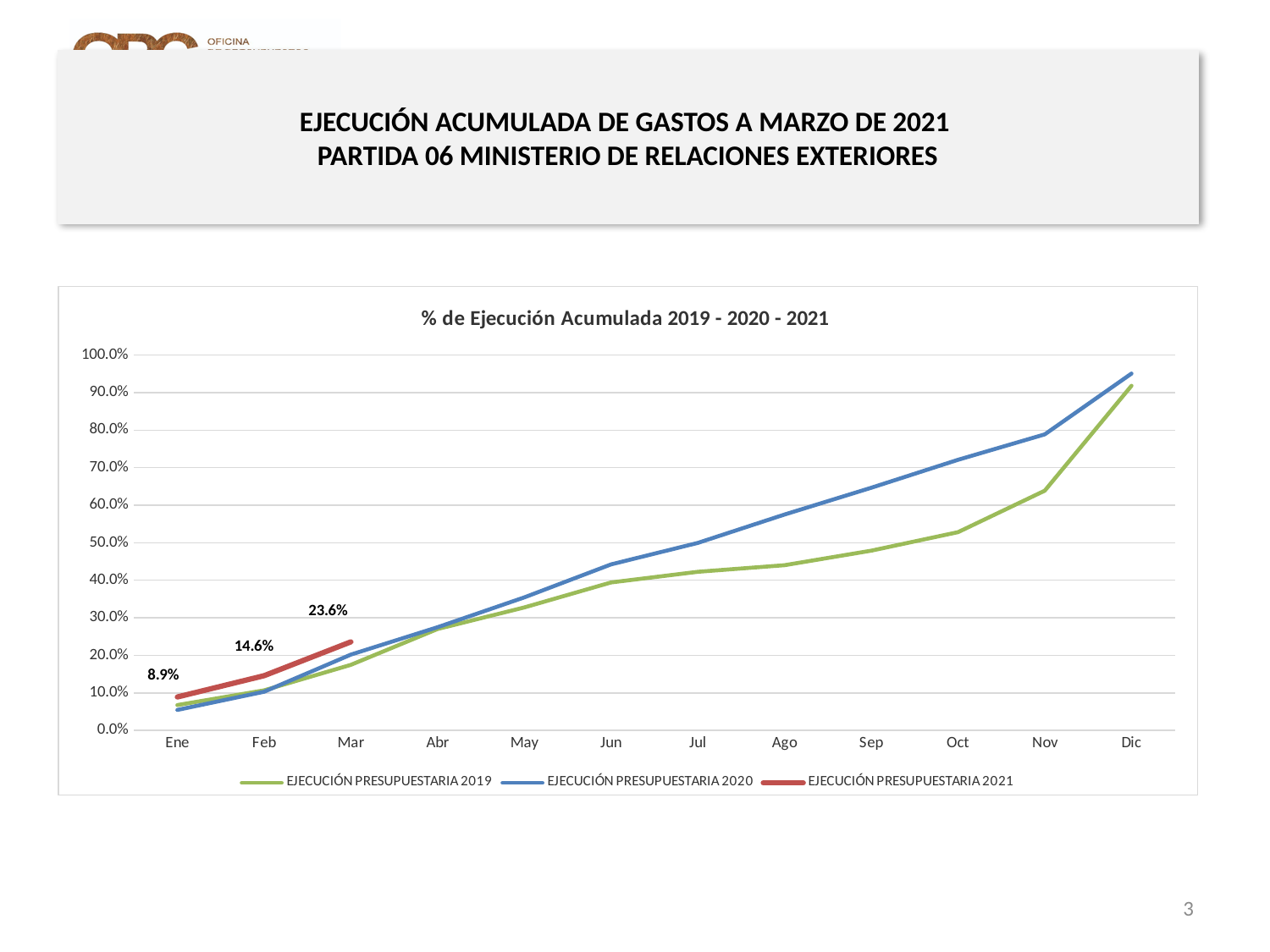
What is the value for EJECUCIÓN PRESUPUESTARIA 2021 in Ene? 8.9% Is the value for EJECUCIÓN PRESUPUESTARIA 2020 in Dic greater or less than 90.0%? greater What is the value for EJECUCIÓN PRESUPUESTARIA 2021 in Feb? 14.6% Which month has the highest value for EJECUCIÓN PRESUPUESTARIA 2021? Mar By how much does the EJECUCIÓN PRESUPUESTARIA 2021 value in Mar exceed its value in Ene? 14.7% Does the EJECUCIÓN PRESUPUESTARIA 2020 line rise or fall from Ene to Dic? Rises In Nov, which series has the larger value: EJECUCIÓN PRESUPUESTARIA 2019 or EJECUCIÓN PRESUPUESTARIA 2020? EJECUCIÓN PRESUPUESTARIA 2020 What kind of chart is shown on the slide? Line chart How many months are shown on the x axis? 12 What is the value for EJECUCIÓN PRESUPUESTARIA 2021 in Mar? 23.6% What is the difference between the EJECUCIÓN PRESUPUESTARIA 2021 values for Feb and Ene? 5.7% How many series does the legend list? 3